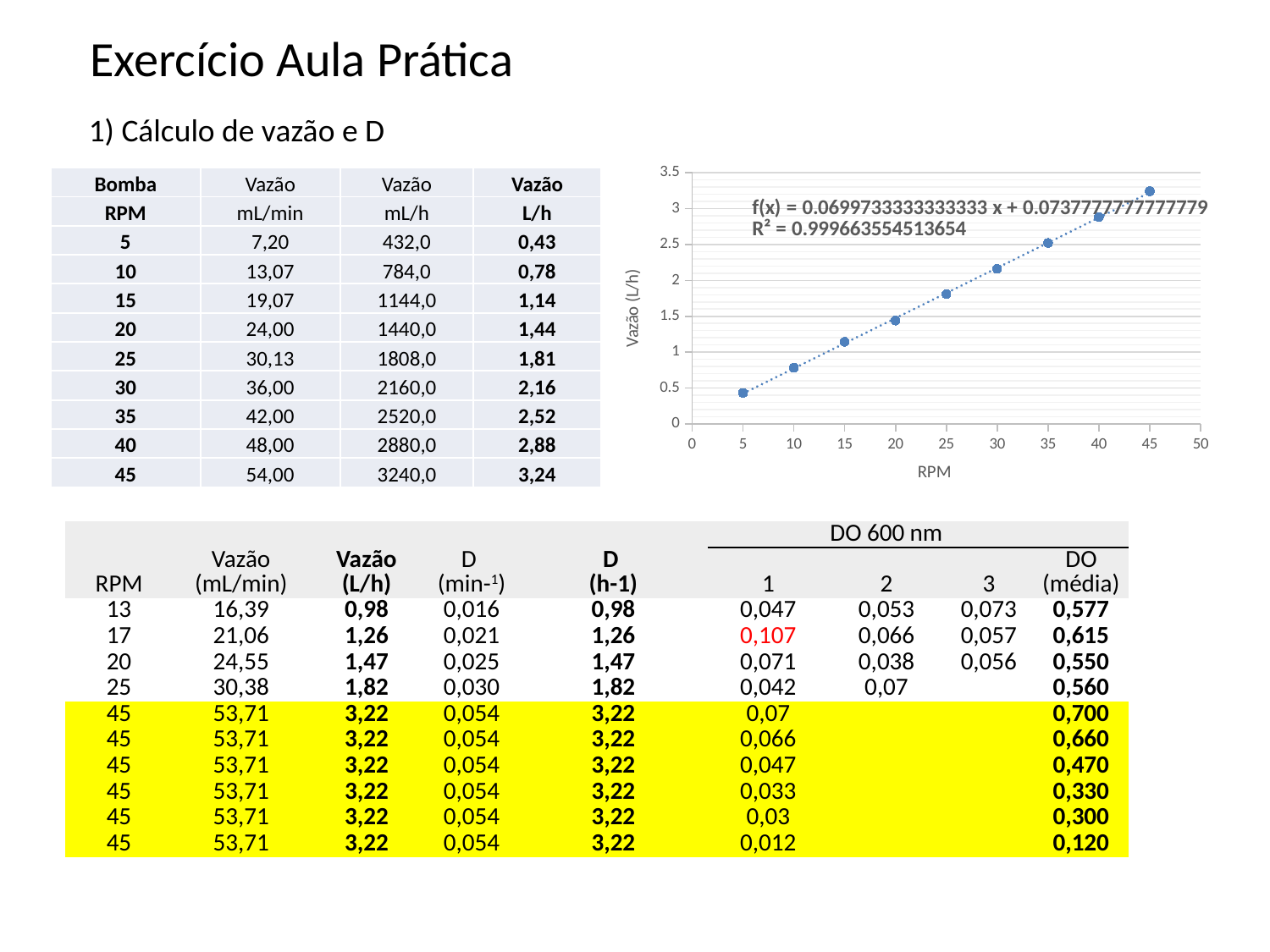
Is the value for RPM 45 greater or less than 3? greater Is the value for RPM 25 greater or less than 1.5? greater Is the value for RPM 40 greater or less than 2.5? greater Which RPM value has the highest Vazão (L/h) in the chart? 45 What is the label of the y axis of the chart? Vazão (L/h) What R² value is displayed on the chart? 0.999663554513654 How many data points are plotted in the chart? 9 What kind of chart is shown on the slide? scatter chart Which RPM value has the lowest Vazão (L/h) in the chart? 5 Which has a larger Vazão (L/h) in the chart, RPM 10 or RPM 15? RPM 15 Do the plotted values rise or fall as RPM increases along the x axis? rise